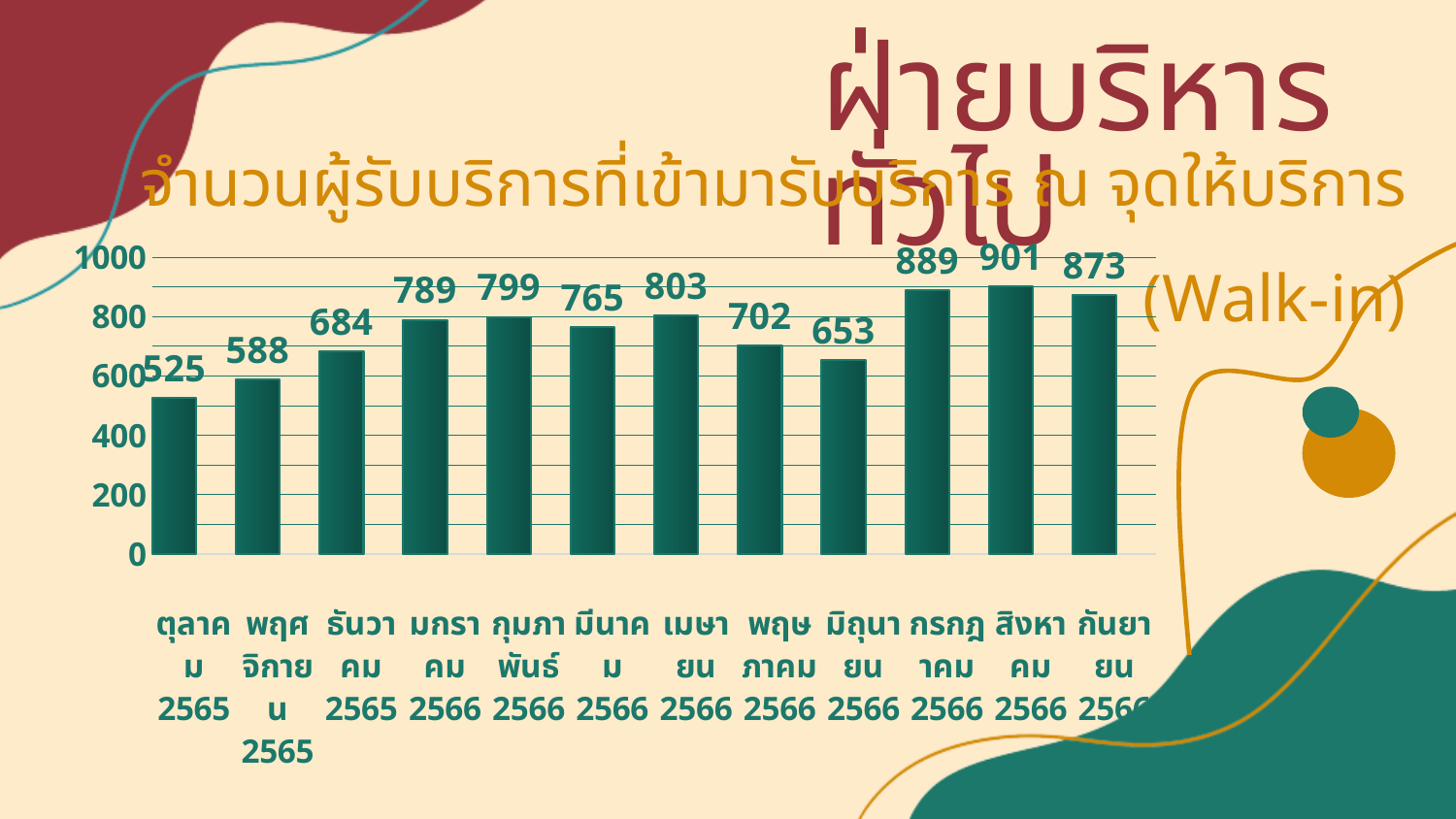
Which month has the highest value? สิงหาคม 2566 Does the value rise or fall from พฤษภาคม 2566 to มิถุนายน 2566? fall Which is larger, the value for เมษายน 2566 or the value for มีนาคม 2566? เมษายน 2566 What is the difference between the values for กุมภาพันธ์ 2566 and มีนาคม 2566? 34 What kind of chart is shown on the slide? bar chart Is the value for กรกฎาคม 2566 greater or less than 800? greater Which month has the lowest value? ตุลาคม 2565 What is the value for มิถุนายน 2566? 653 How many months are shown in the chart? 12 What is the value for ตุลาคม 2565? 525 What is the difference between the values for สิงหาคม 2566 and ตุลาคม 2565? 376 What is the value for มกราคม 2566? 789